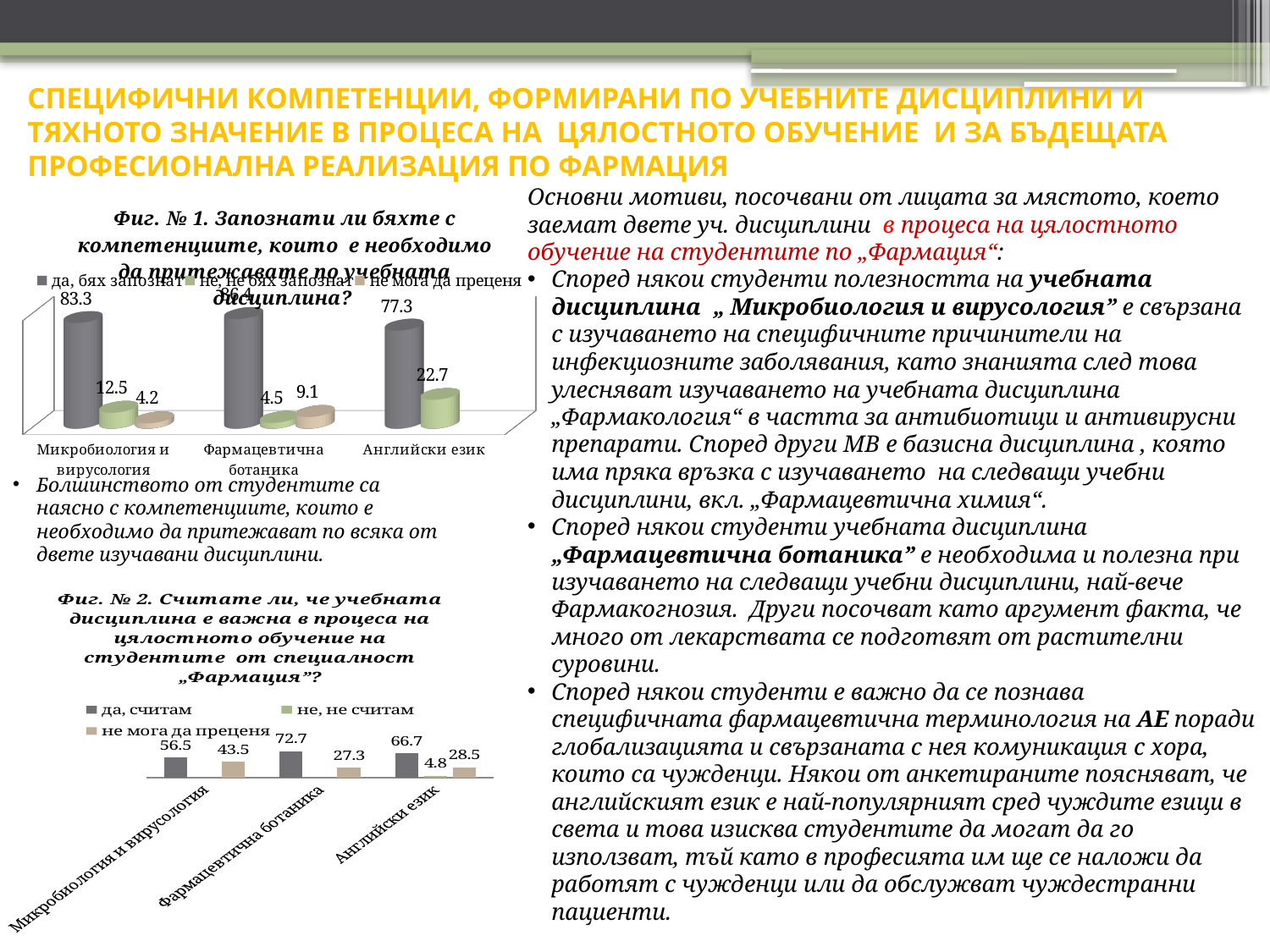
In the chart Фиг. № 1, what is the value of "не мога да преценя" for Фармацевтична ботаника? 9.1 What kind of chart is Фиг. № 2? bar chart In the chart Фиг. № 1, what is the value of "да, бях запознат" for Микробиология и вирусология? 83.3 In the chart Фиг. № 2, what is the value of "да, считам" for Фармацевтична ботаника? 72.7 In the chart Фиг. № 1, what is the value of "не, не бях запознат" for Английски език? 22.7 How many disciplines are shown on the x axis of the chart Фиг. № 1? 3 In the chart Фиг. № 2, what is the value of "да, считам" for Микробиология и вирусология? 56.5 How many series does the legend of the chart Фиг. № 1 list? 3 In the chart Фиг. № 1, which discipline has the highest value for "да, бях запознат"? Фармацевтична ботаника In the chart Фиг. № 1, what is the difference between the "да, бях запознат" values for Микробиология и вирусология and Английски език? 6.0 In the chart Фиг. № 2, which discipline has the highest value for "да, считам"? Фармацевтична ботаника In the chart Фиг. № 2, which has the larger "да, считам" value: Микробиология и вирусология or Английски език? Английски език